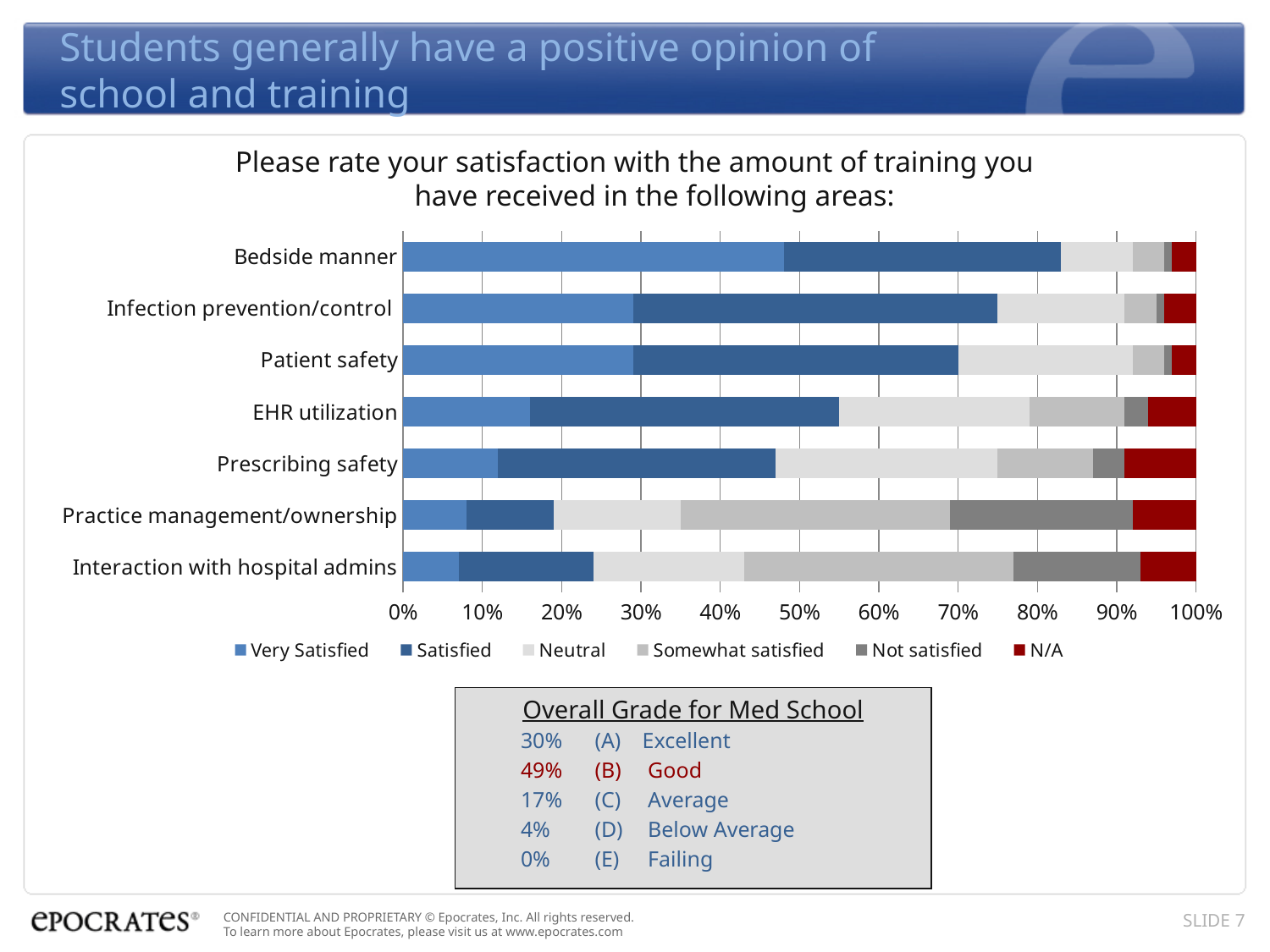
Which has a larger Satisfied segment: Infection prevention/control or Practice management/ownership? Infection prevention/control Which training area has the largest Very Satisfied segment? Bedside manner How many training areas (categories) are plotted in the chart? 7 What is the question shown as the chart's title? Please rate your satisfaction with the amount of training you have received in the following areas: Is the Very Satisfied value for Practice management/ownership greater or less than 10%? less Is the Very Satisfied value for Bedside manner greater or less than 40%? greater Is the Very Satisfied value for Interaction with hospital admins greater or less than 10%? less How many series does the chart legend list? 6 Which legend entry is shown in red? N/A What kind of chart is shown on the slide? Stacked bar chart Which has a larger Very Satisfied segment: Bedside manner or Patient safety? Bedside manner